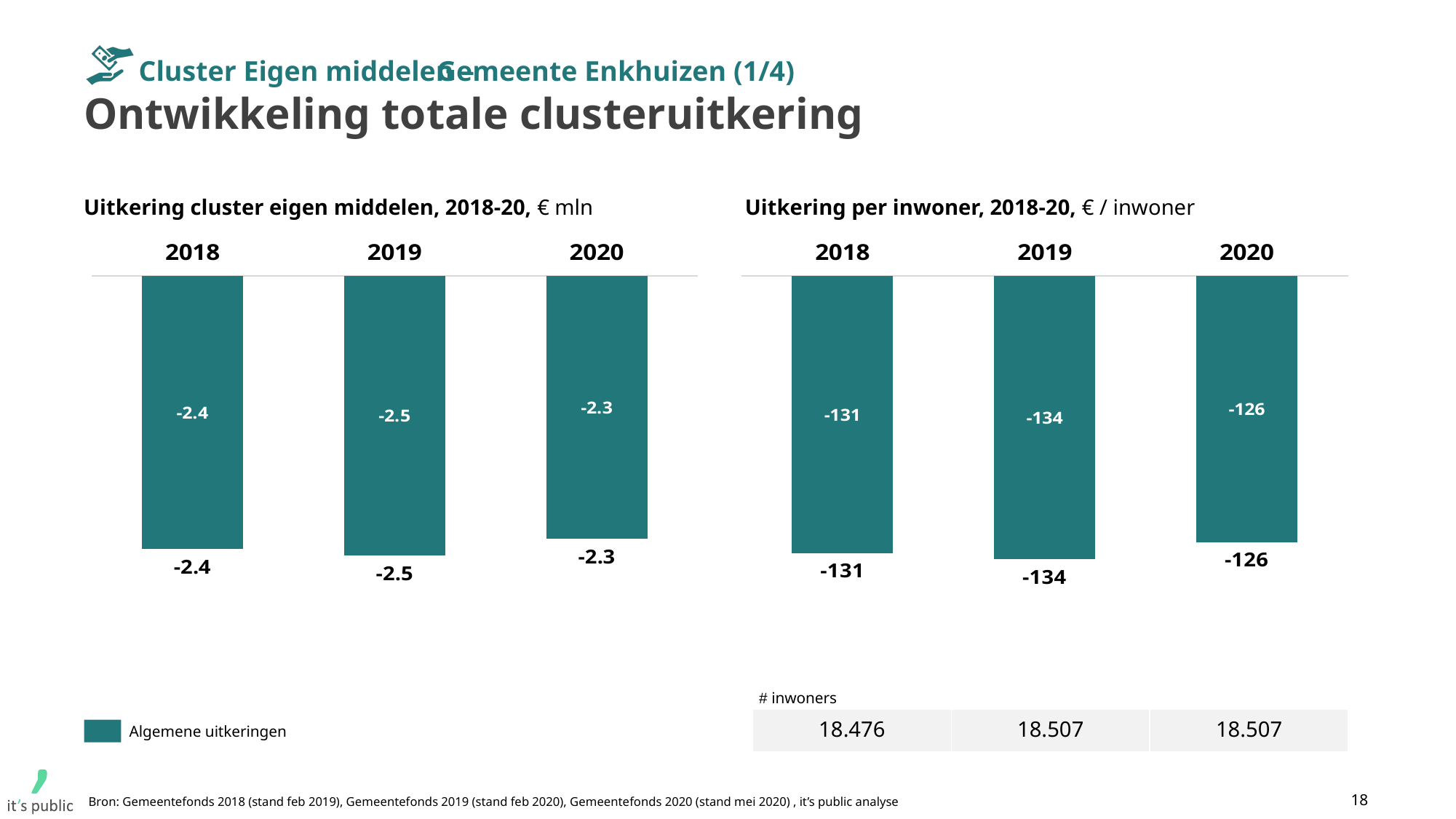
In the chart 'Uitkering per inwoner, 2018-20', is the value for 2018 or 2020 more negative? 2018 In the chart 'Uitkering cluster eigen middelen, 2018-20', which year has the lowest (most negative) value? 2019 What type of chart is 'Uitkering per inwoner, 2018-20'? Bar chart In the chart 'Uitkering per inwoner, 2018-20', what is the value for 2018? -131 In the chart 'Uitkering per inwoner, 2018-20', what is the value for 2020? -126 In the chart 'Uitkering cluster eigen middelen, 2018-20', what is the value for 2019? -2.5 In the chart 'Uitkering cluster eigen middelen, 2018-20', what is the difference between the 2019 value and the 2020 value? 0.2 In the chart 'Uitkering per inwoner, 2018-20', which year has the lowest (most negative) value? 2019 In the chart 'Uitkering per inwoner, 2018-20', what is the difference between the 2019 value and the 2020 value? 8 How many years are shown in the chart 'Uitkering cluster eigen middelen, 2018-20'? 3 What is the legend entry shown below the left chart? Algemene uitkeringen In the chart 'Uitkering cluster eigen middelen, 2018-20', what is the value for 2020? -2.3